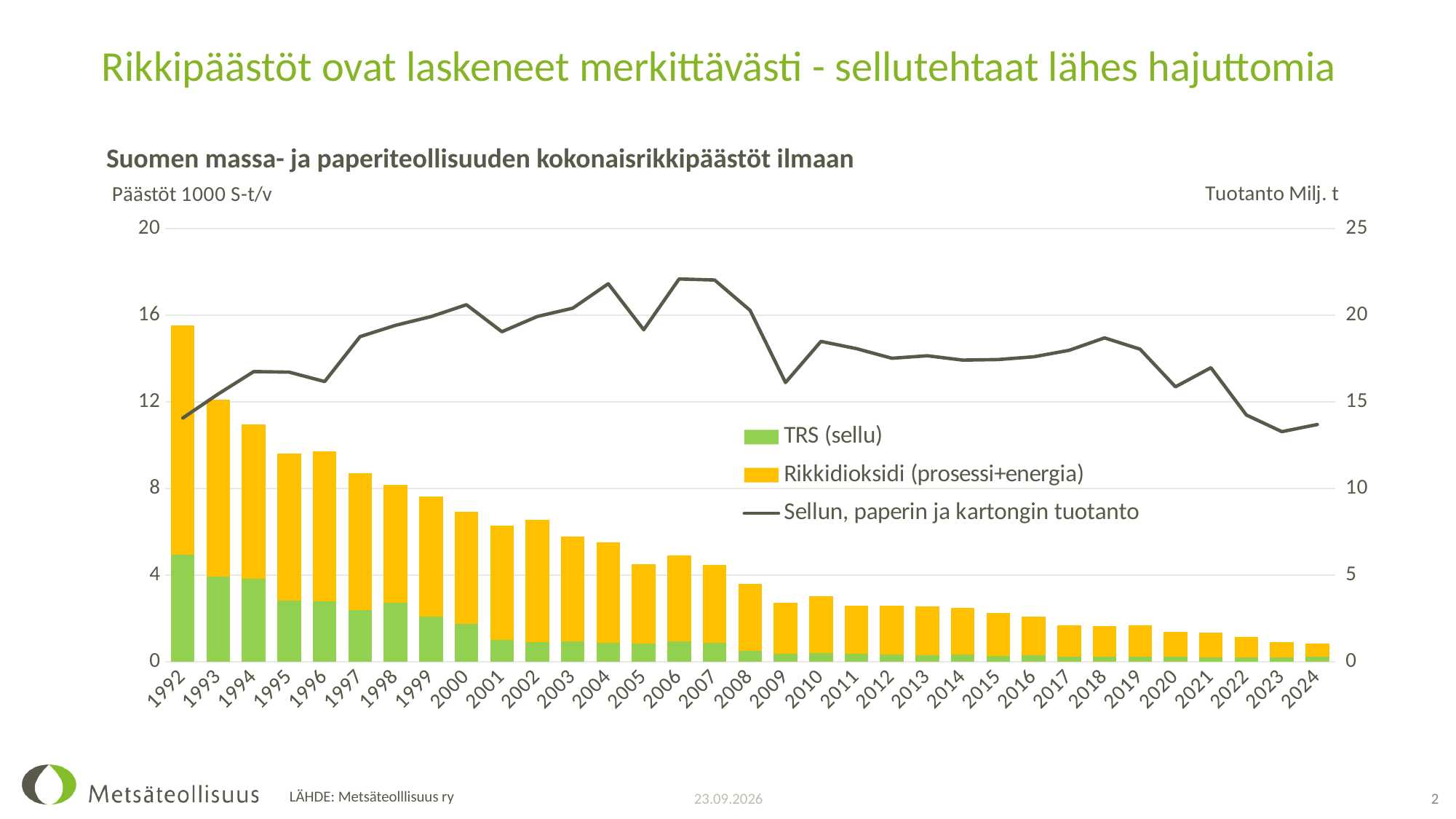
How many years are shown along the x axis of the chart? 33 Which year has the larger total emissions bar, 1993 or 1994? 1993 Which year has the highest total emissions bar? 1992 Which year has the larger total emissions bar, 2008 or 2009? 2008 On the right-hand axis, is the production line value for 2006 greater or less than 20? greater Is the total emissions bar for 1992 greater or less than 12? greater Do the total emissions bars rise or fall from 1992 to 2024? Fall Is the TRS (sellu) value for 1992 greater or less than 4? greater What kind of chart is shown on the slide? A stacked bar chart combined with a line How many series does the chart's legend list? 3 What is the title of the chart? Suomen massa- ja paperiteollisuuden kokonaisrikkipäästöt ilmaan